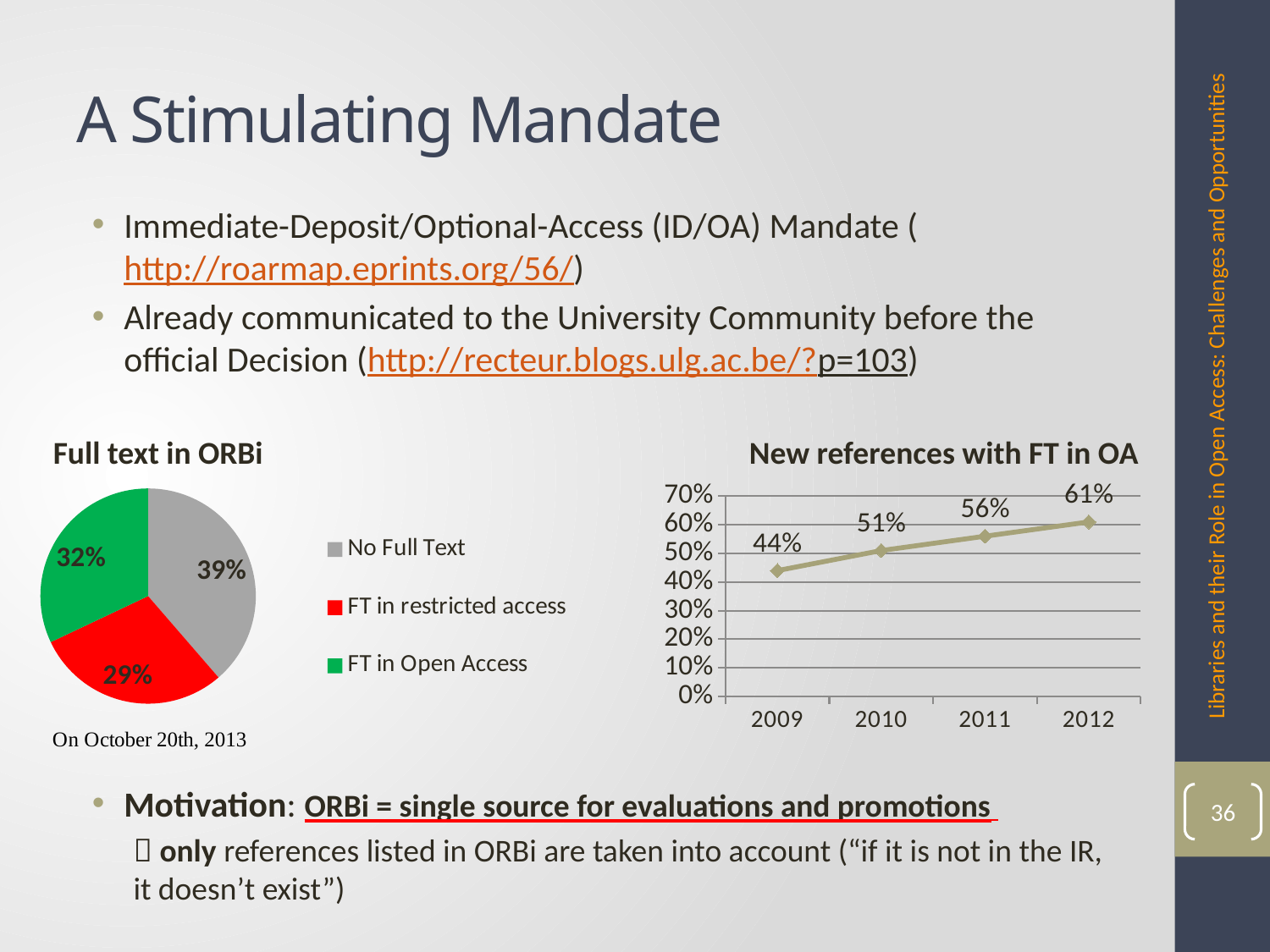
In the 'New references with FT in OA' chart, what is the difference between the 2012 and 2009 values? 17% In the 'Full text in ORBi' pie chart, how many categories does the legend list? 3 In the 'Full text in ORBi' pie chart, which category has the largest slice? No Full Text In the 'Full text in ORBi' pie chart, which category has the smallest slice? FT in restricted access In the 'Full text in ORBi' pie chart, what share is 'No Full Text'? 39% In the 'Full text in ORBi' pie chart, what share is 'FT in restricted access'? 29% In the 'New references with FT in OA' chart, do the values rise or fall from 2009 to 2012? Rise In the 'New references with FT in OA' chart, what is the value for 2009? 44% In the 'New references with FT in OA' chart, what is the value for 2012? 61% What kind of chart is 'Full text in ORBi'? Pie chart What kind of chart is 'New references with FT in OA'? Line chart In the 'Full text in ORBi' pie chart, what share is 'FT in Open Access'? 32%